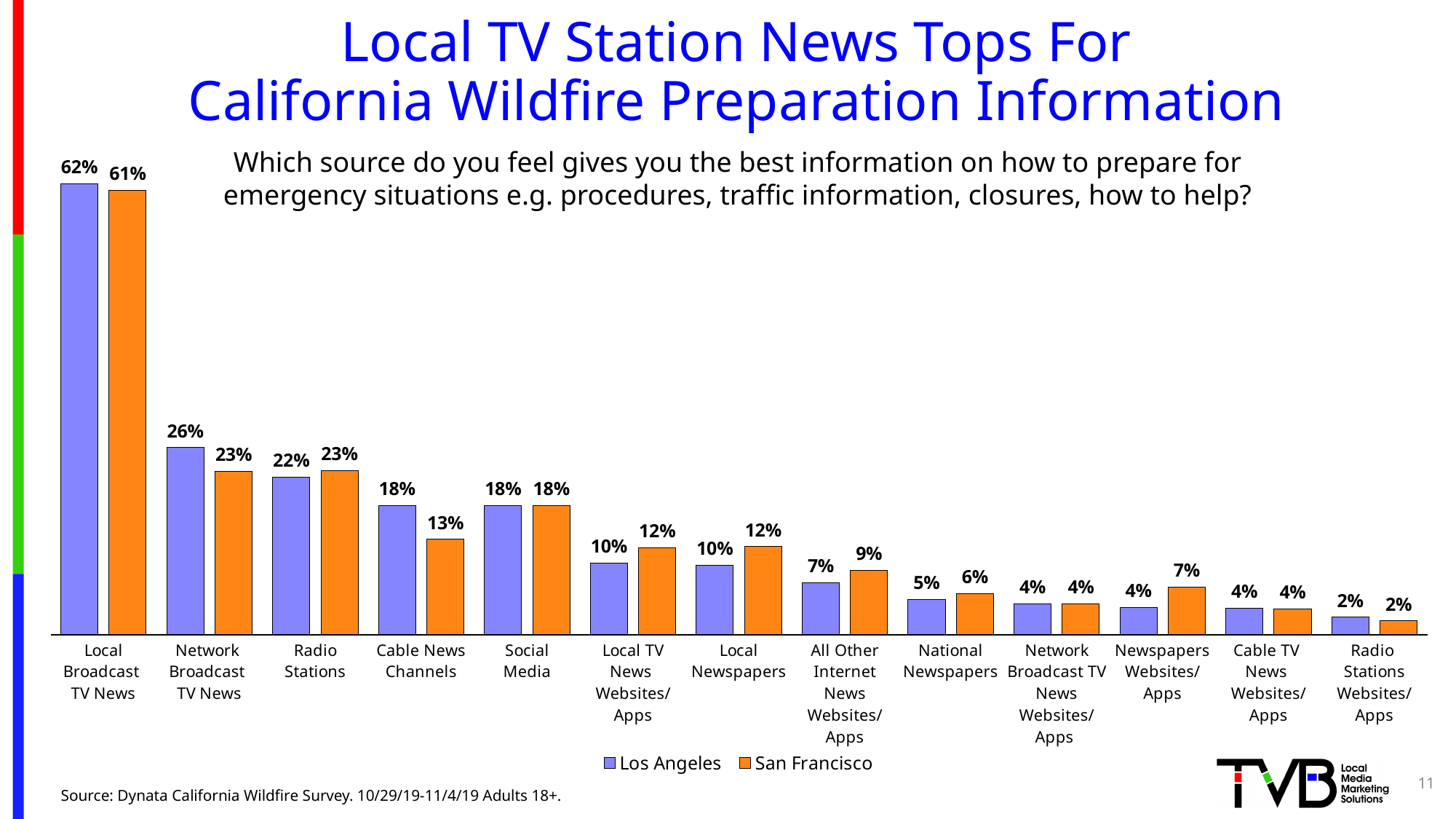
Which is larger for Radio Stations: the Los Angeles value or the San Francisco value? San Francisco How many categories are shown on the x axis? 13 Which series is shown in orange in the legend? San Francisco What is the San Francisco value for Cable News Channels? 13% What is the difference between the Los Angeles and San Francisco values for Network Broadcast TV News? 3% What is the San Francisco value for Newspapers Websites/Apps? 7% What is the Los Angeles value for Local Broadcast TV News? 62% How many series does the legend list? 2 Which category has the highest San Francisco value? Local Broadcast TV News What kind of chart is shown on the slide? bar chart Do the Los Angeles values generally rise or fall from left to right along the x axis? fall Which category has the lowest Los Angeles value? Radio Stations Websites/Apps